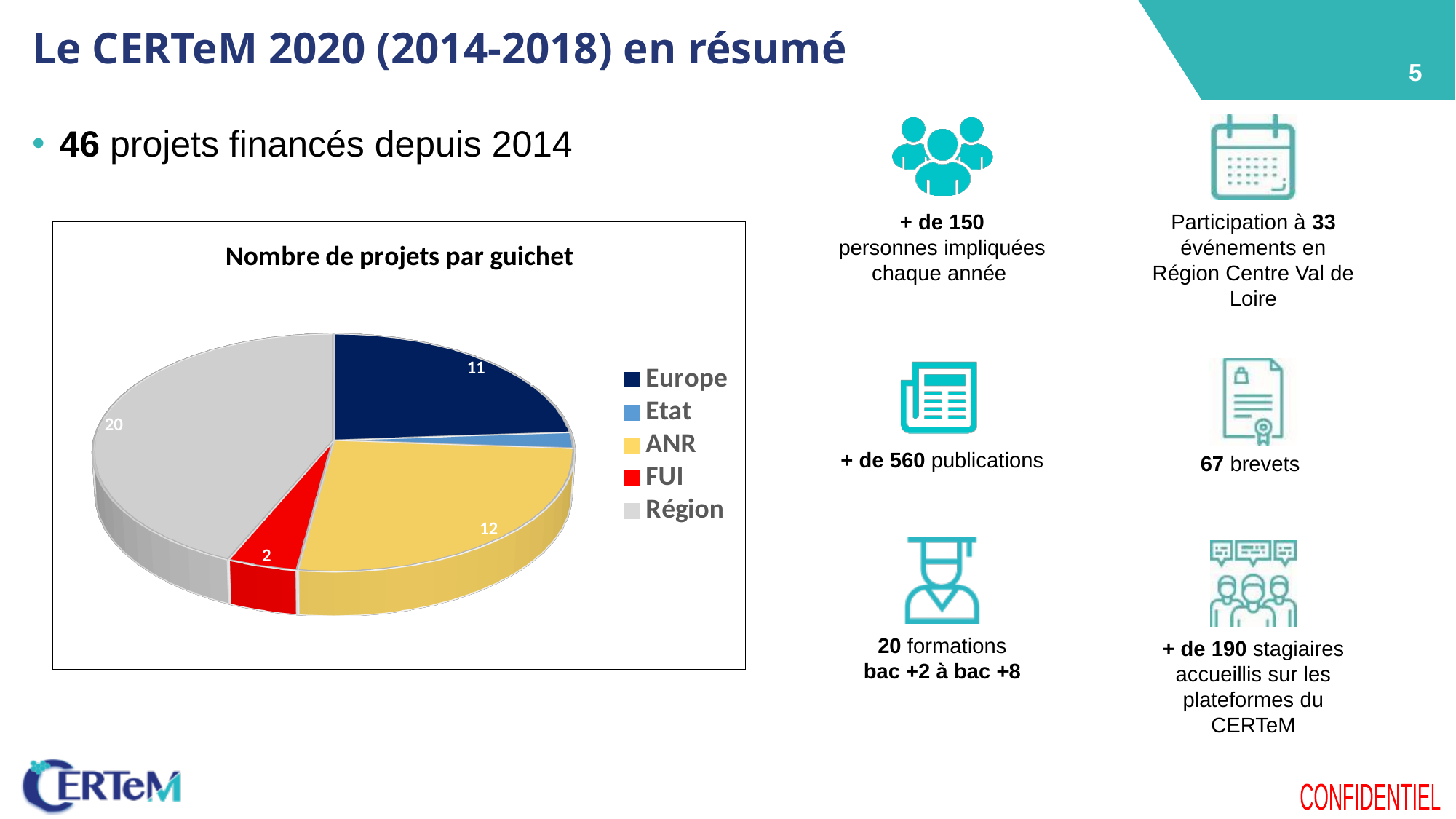
Which has more projects, ANR or FUI? ANR What type of chart is shown on the slide? pie chart How many projects are shown for Europe in the pie chart? 11 Which guichet has the smallest slice in the pie chart? Etat What is the title of the chart? Nombre de projets par guichet How many categories (guichets) does the pie chart show? 5 What is the difference between the number of projects for Région and for Europe? 9 How many projects are shown for ANR in the pie chart? 12 How many projects are shown for FUI in the pie chart? 2 How many projects are shown for Région in the pie chart? 20 What colour is the Région slice in the pie chart? grey Which guichet has the largest number of projects in the pie chart? Région